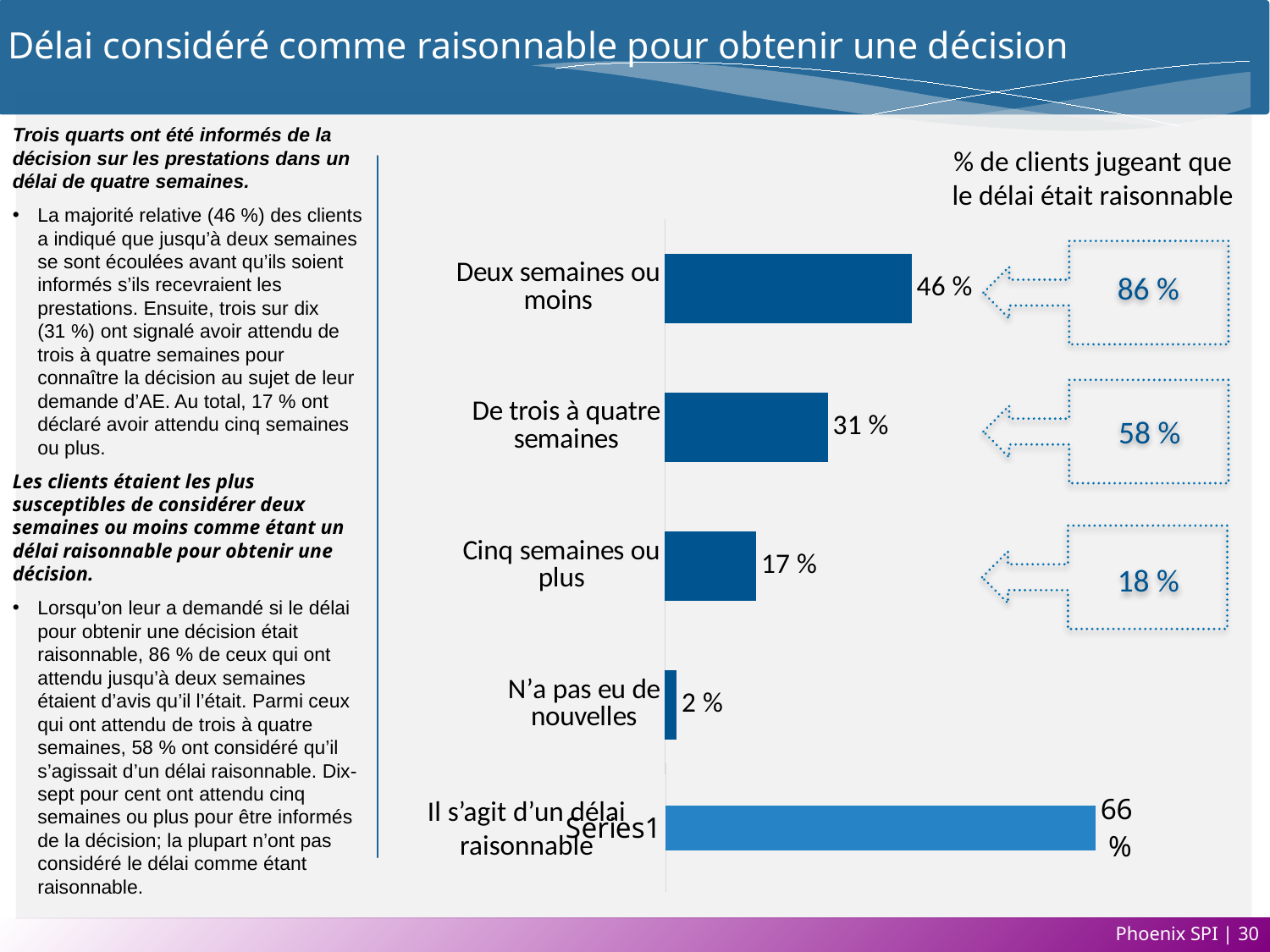
According to the callout box next to "Deux semaines ou moins", what percentage of clients judged the delay reasonable? 86 % What kind of chart is shown on the slide? bar chart How many bars are plotted in the chart? 5 Which category has the lowest value in the chart? N'a pas eu de nouvelles What is the value for "Il s'agit d'un délai raisonnable"? 66 % What is the value for "N'a pas eu de nouvelles"? 2 % Which is larger, the value for "Cinq semaines ou plus" or the value for "De trois à quatre semaines"? De trois à quatre semaines What is the value for "Deux semaines ou moins"? 46 % Which category has the highest value in the chart? Il s'agit d'un délai raisonnable What is the value for "Cinq semaines ou plus"? 17 % What is the difference between the values for "Deux semaines ou moins" and "De trois à quatre semaines"? 15 percentage points What is the value for "De trois à quatre semaines"? 31 %